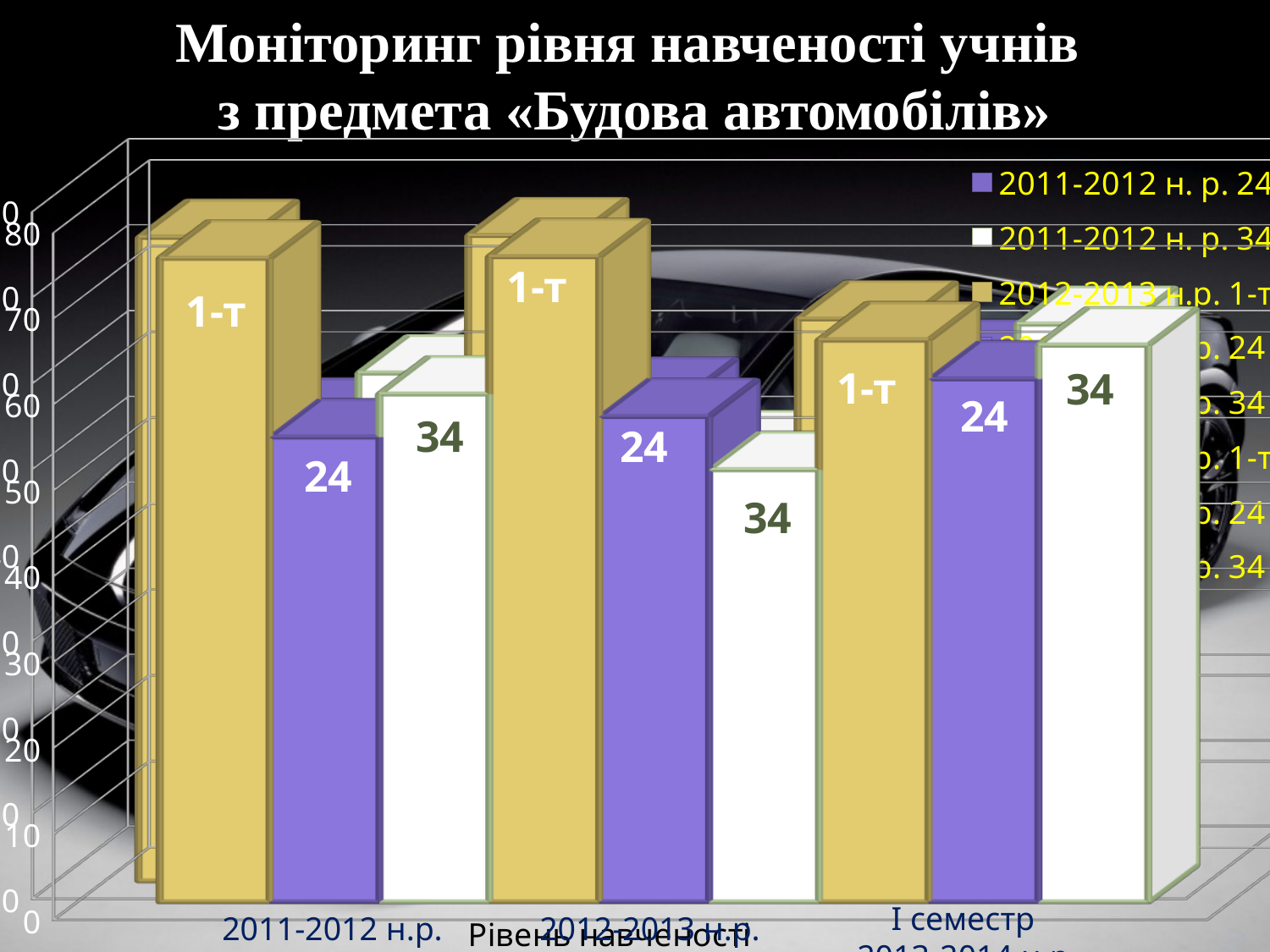
What is the title of the chart on the slide? Моніторинг рівня навченості учнів з предмета «Будова автомобілів» Is the value of the gold bar labelled 1-т for 2012-2013 н.р. greater or less than 70? greater Is the value of the white bar labelled 34 for І семестр 2013-2014 н.р. greater or less than 60? greater Is the value of the purple bar labelled 24 for 2011-2012 н.р. greater or less than 50? greater Which bar is the lowest in the 2012-2013 н.р. group? 34 (white) How many bars are there in each category group? 3 How many category groups are shown along the x axis? 3 In the 2012-2013 н.р. group, which is larger: the bar labelled 1-т or the bar labelled 24? 1-т Which bar is the highest in the 2011-2012 н.р. group? 1-т (gold) What kind of chart is shown on the slide? bar chart